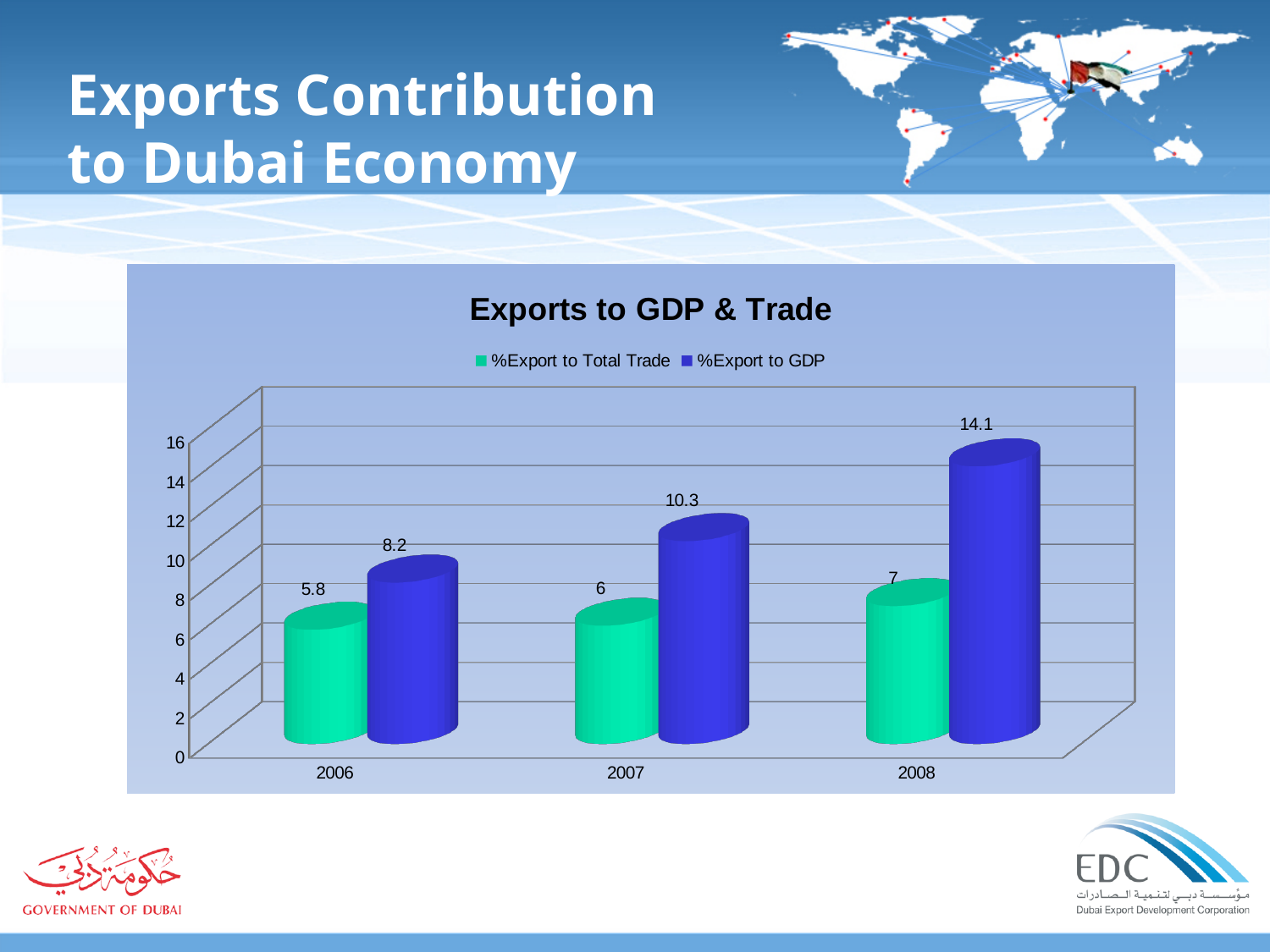
What is the %Export to Total Trade value for 2006? 5.8 What is the %Export to Total Trade value for 2008? 7 Which year has the lowest %Export to Total Trade value? 2006 What is the %Export to GDP value for 2008? 14.1 Which year has the highest %Export to GDP value? 2008 What is the %Export to GDP value for 2007? 10.3 What kind of chart is shown on the slide? Bar chart How many years are shown on the x axis? 3 What is the difference between the %Export to GDP values for 2008 and 2006? 5.9 Which is larger in 2007: %Export to Total Trade or %Export to GDP? %Export to GDP How many series does the legend list? 2 Does the %Export to GDP value rise or fall from 2006 to 2008? Rise